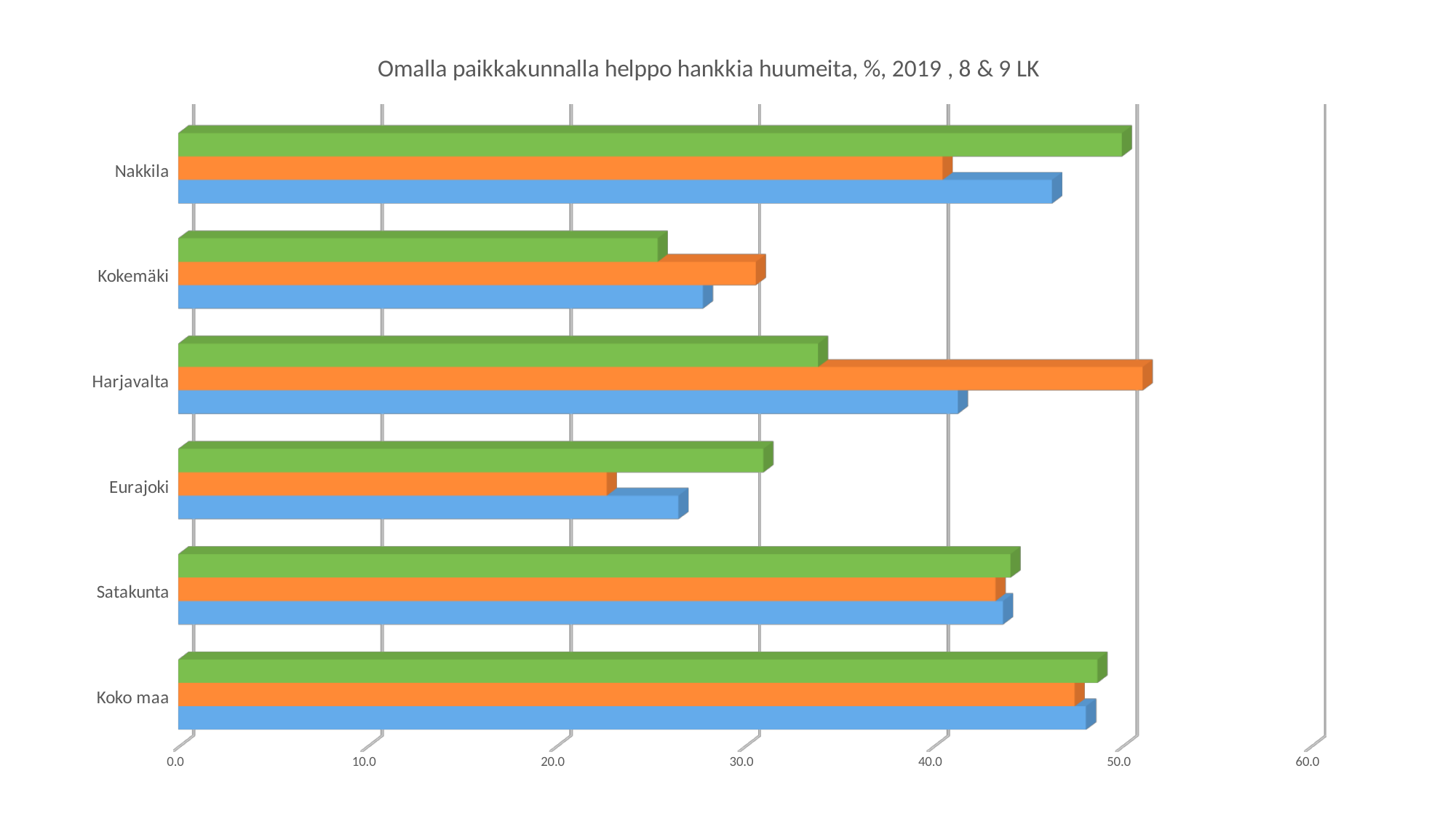
Is the value of the green bar for Nakkila greater or less than 40? greater What kind of chart is shown on the slide? bar chart What is the title of the chart? Omalla paikkakunnalla helppo hankkia huumeita, %, 2019 , 8 & 9 LK How many categories are shown on the vertical axis of the chart? 6 For Harjavalta, which bar is larger, the orange bar or the green bar? orange Is the value of the orange bar for Kokemäki greater or less than 40? less Which category has the lowest green bar? Kokemäki Which category has the highest orange bar? Harjavalta Is the value of the orange bar for Eurajoki greater or less than 30? less For Eurajoki, which bar is larger, the green bar or the orange bar? green How many bars are plotted for each category in the chart? 3